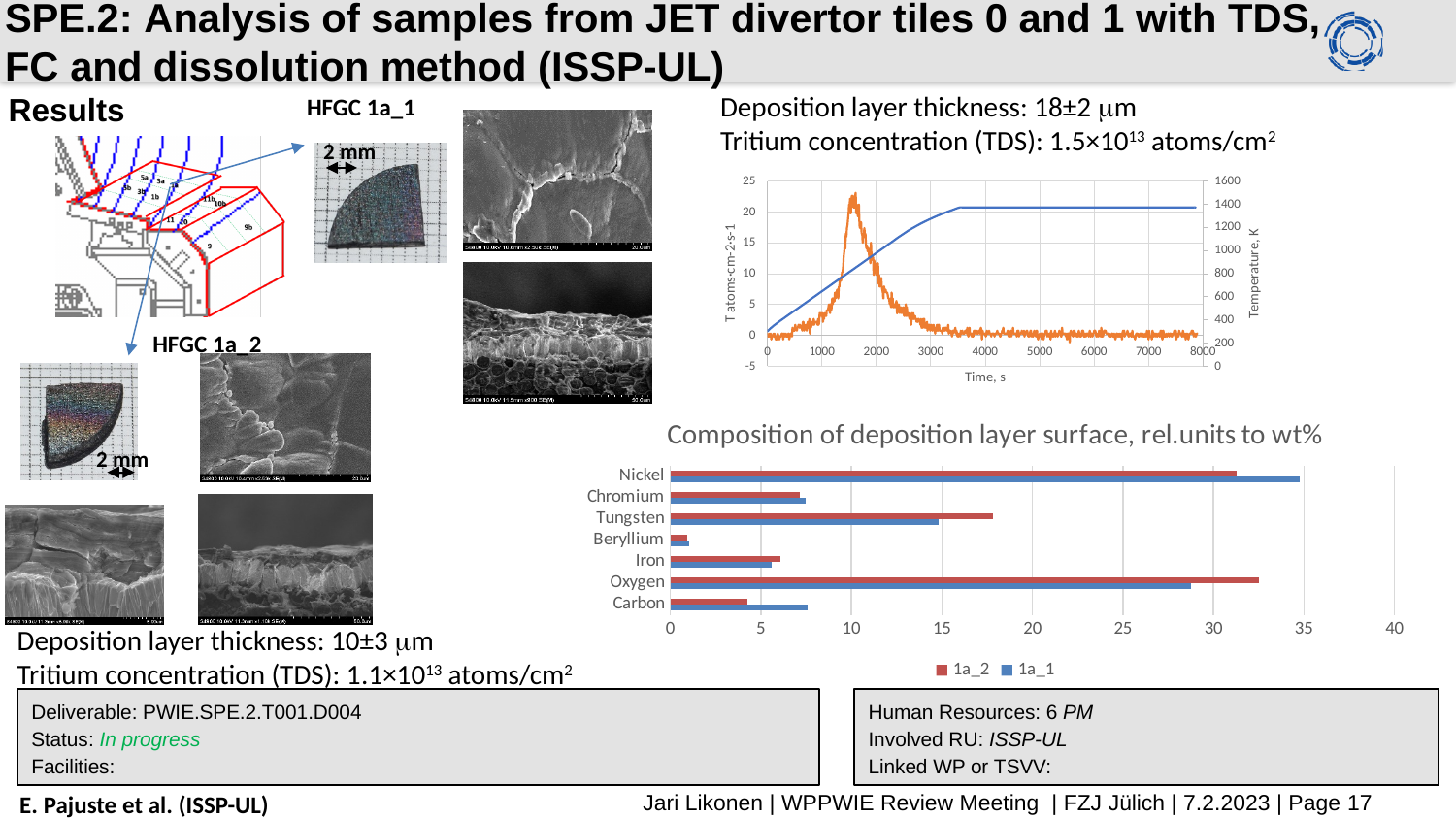
In the 'Composition of deposition layer surface' bar chart, which series has the larger value for Tungsten, 1a_2 or 1a_1? 1a_2 How many elements (categories) are shown in the 'Composition of deposition layer surface' bar chart? 7 What are the two legend entries of the 'Composition of deposition layer surface' bar chart? 1a_2 and 1a_1 In the 'Composition of deposition layer surface' bar chart, is the value of Carbon for 1a_2 greater or less than 5? less What kind of chart is the 'Composition of deposition layer surface, rel.units to wt%' chart? bar chart In the 'Composition of deposition layer surface' bar chart, which element has the lowest value for series 1a_2? Beryllium In the 'Composition of deposition layer surface' bar chart, which element has the highest value for series 1a_1? Nickel In the 'Composition of deposition layer surface' bar chart, is the value of Oxygen for 1a_2 greater or less than 30? greater In the 'Composition of deposition layer surface' bar chart, which series has the larger value for Carbon, 1a_2 or 1a_1? 1a_1 How many series does the legend of the 'Composition of deposition layer surface' bar chart list? 2 What is the x-axis label of the line chart in the upper right of the slide? Time, s In the 'Composition of deposition layer surface' bar chart, is the value of Nickel for 1a_1 greater or less than 30? greater